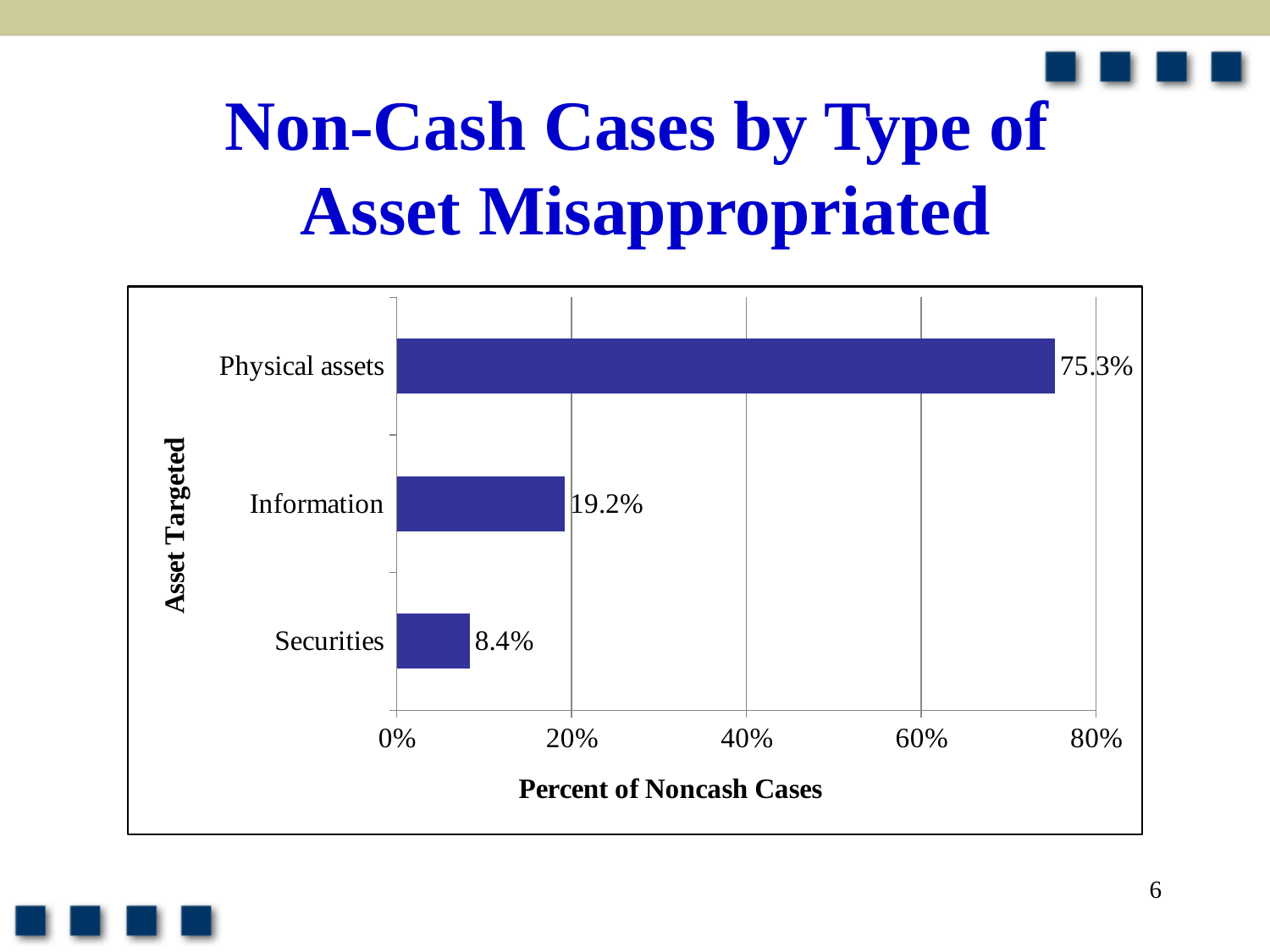
Is the value for physical assets greater or less than 60%? greater Which asset targeted has the highest percent of noncash cases? Physical assets What is the difference in percentage points between information and securities? 10.8 Which asset targeted has the lowest percent of noncash cases? Securities What is the label of the horizontal axis of the chart? Percent of Noncash Cases Which has a larger percent of noncash cases, information or securities? Information What percent of noncash cases targeted information? 19.2% What percent of noncash cases targeted physical assets? 75.3% What kind of chart is shown on the slide? Bar chart How many asset categories are shown in the chart? 3 What is the difference in percentage points between physical assets and information? 56.1 What percent of noncash cases targeted securities? 8.4%